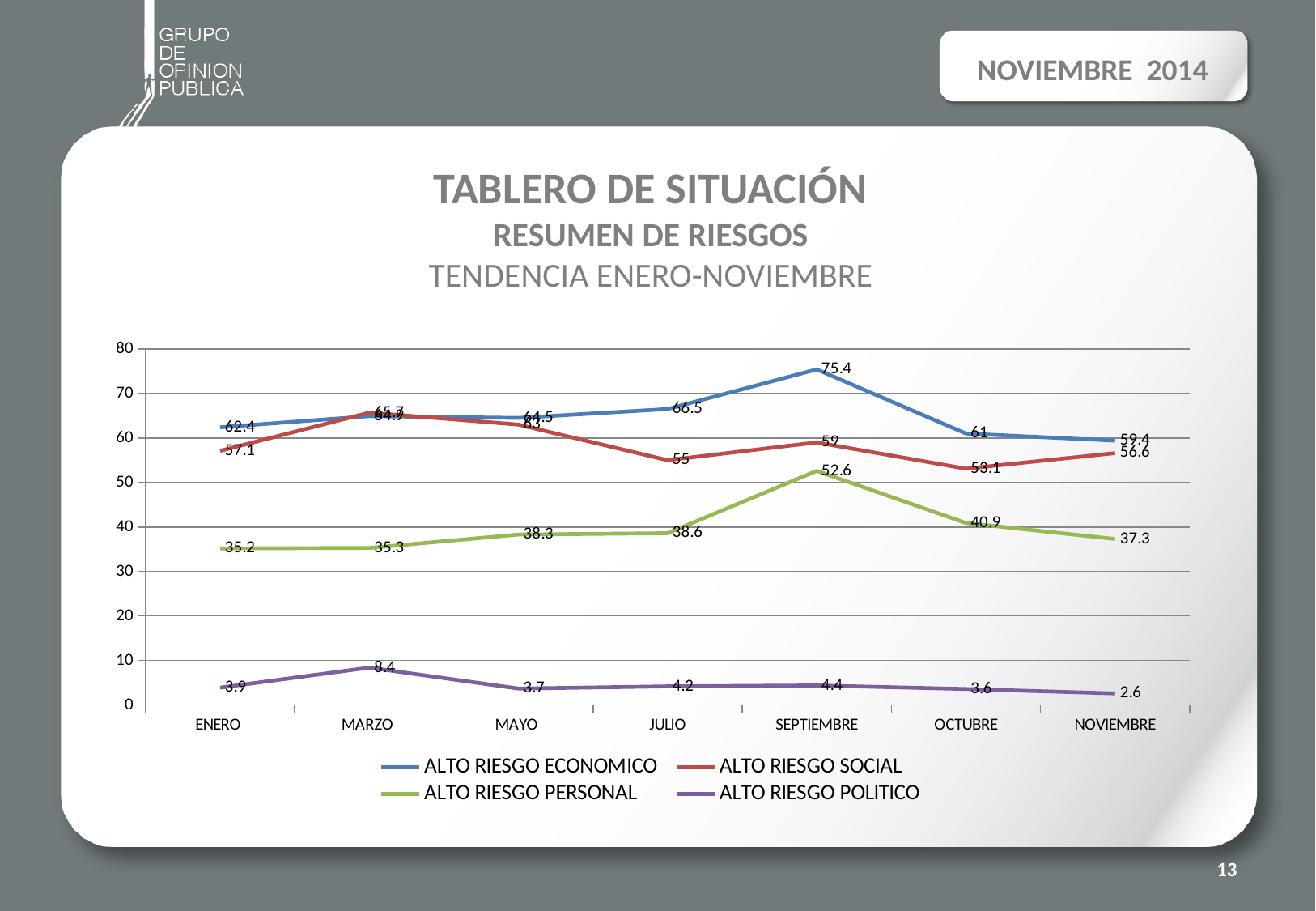
What kind of chart is shown on the slide? line chart What is the value for ALTO RIESGO POLITICO in MARZO? 8.4 How many series does the legend list? 4 How many months are shown on the x axis? 7 Which is larger in JULIO: ALTO RIESGO SOCIAL or ALTO RIESGO PERSONAL? ALTO RIESGO SOCIAL What is the value for ALTO RIESGO ECONOMICO in SEPTIEMBRE? 75.4 What is the value for ALTO RIESGO PERSONAL in NOVIEMBRE? 37.3 In which month is ALTO RIESGO POLITICO lowest? NOVIEMBRE Does ALTO RIESGO PERSONAL rise or fall from SEPTIEMBRE to NOVIEMBRE? fall What is the difference between ALTO RIESGO ECONOMICO and ALTO RIESGO SOCIAL in NOVIEMBRE? 2.8 What is the value for ALTO RIESGO SOCIAL in OCTUBRE? 53.1 In which month does ALTO RIESGO ECONOMICO reach its highest value? SEPTIEMBRE